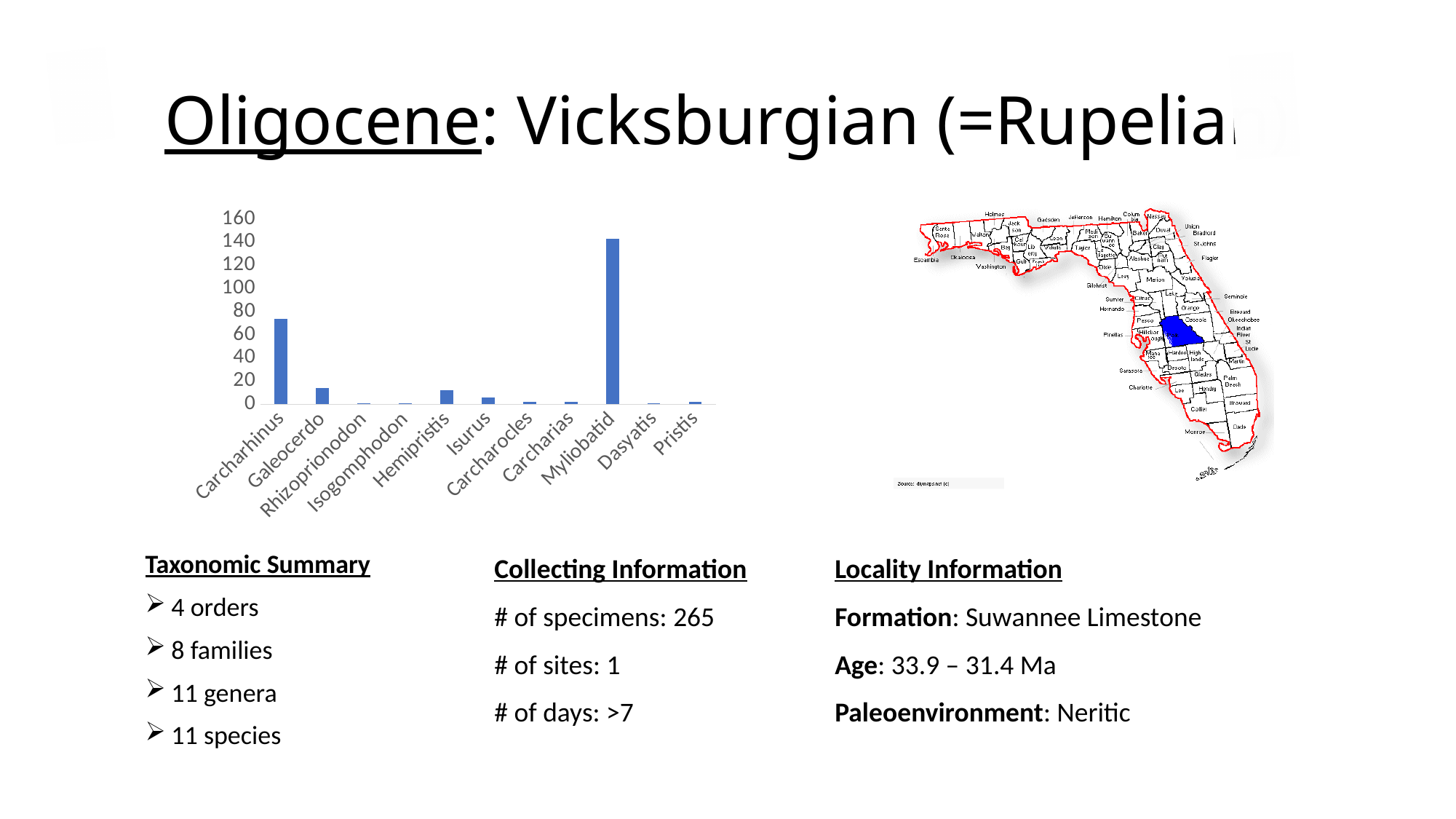
Which is larger, the value for Carcharhinus or the value for Galeocerdo? Carcharhinus What kind of chart is shown on the slide? bar chart Is the value for Carcharhinus greater or less than 80? less Which category has the highest value in the bar chart? Myliobatid Which is larger, the value for Myliobatid or the value for Carcharhinus? Myliobatid What is the highest tick value shown on the y axis of the bar chart? 160 Which category has the second-highest value in the bar chart? Carcharhinus Is the value for Carcharhinus greater or less than 60? greater How many categories are plotted on the x axis of the bar chart? 11 Is the value for Galeocerdo greater or less than 20? less Which is larger, the value for Hemipristis or the value for Isurus? Hemipristis